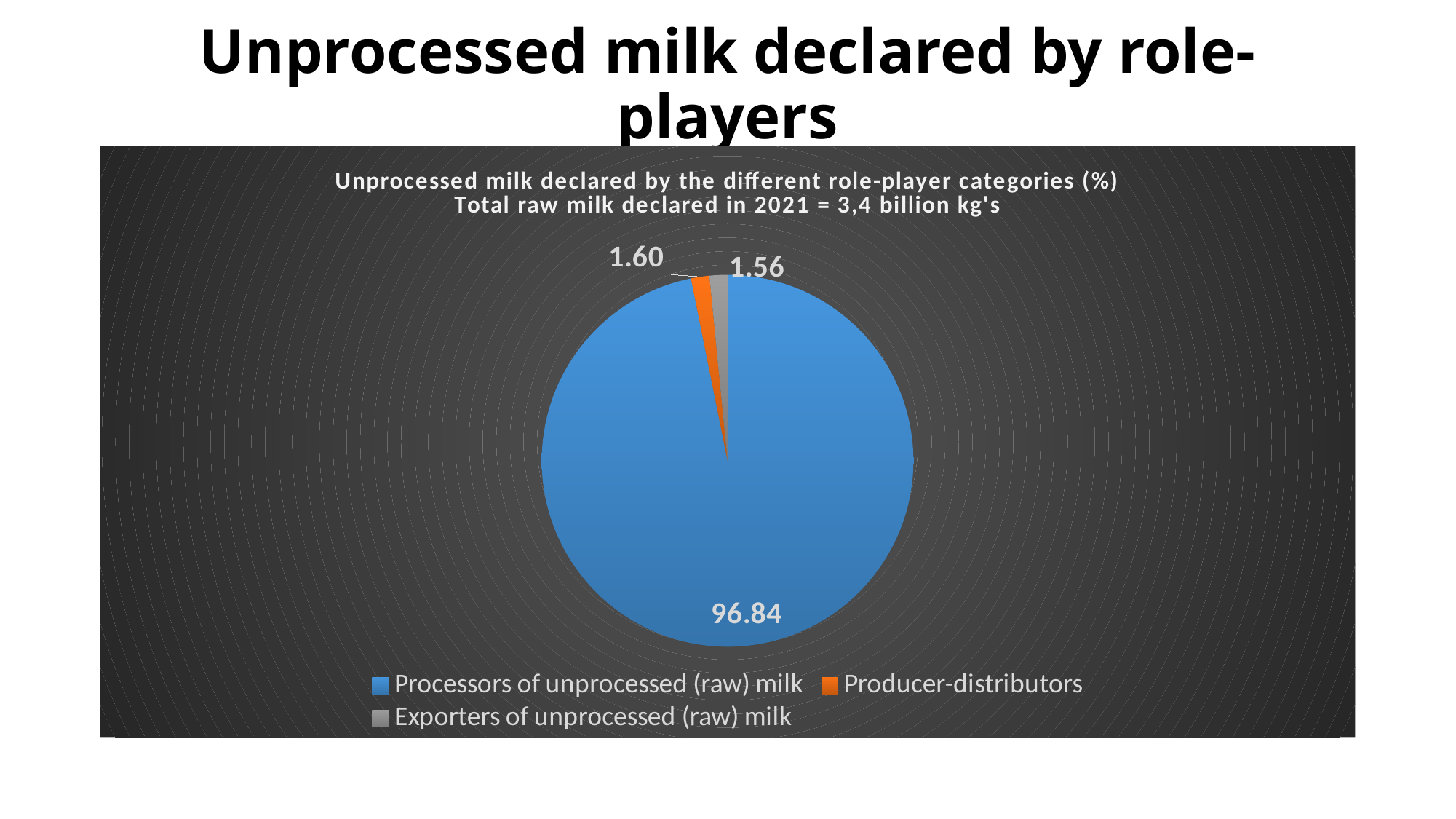
Which role-player category declared the smallest share of unprocessed milk? Exporters of unprocessed (raw) milk How many role-player categories are shown in the pie chart? 3 Which role-player category declared the largest share of unprocessed milk? Processors of unprocessed (raw) milk What percentage of unprocessed milk was declared by processors of unprocessed (raw) milk? 96.84 Which colour represents producer-distributors in the pie chart? orange What is the difference between the share declared by producer-distributors and the share declared by exporters of unprocessed (raw) milk? 0.04 What percentage of unprocessed milk was declared by producer-distributors? 1.60 According to the chart title, what was the total raw milk declared in 2021? 3,4 billion kg's What kind of chart is shown on the slide? pie chart Is the share declared by processors of unprocessed (raw) milk larger or smaller than the share declared by producer-distributors? larger What percentage of unprocessed milk was declared by exporters of unprocessed (raw) milk? 1.56 What is the difference between the share declared by processors of unprocessed (raw) milk and the share declared by producer-distributors? 95.24